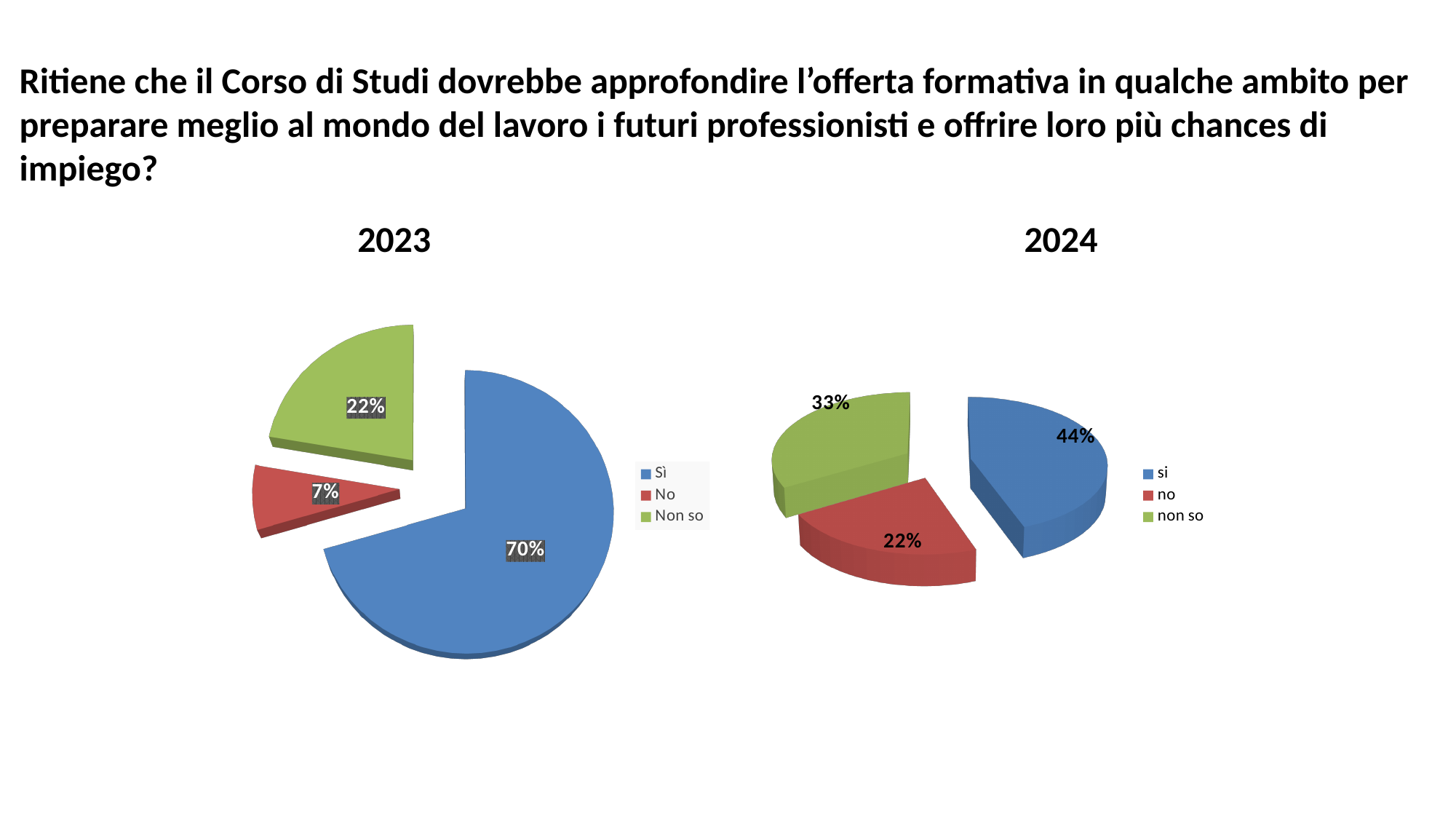
Which is larger: the "Non so" share in the 2023 chart or the "non so" share in the 2024 chart? 2024 What is the difference between the "Sì" share in the 2023 chart and the "si" share in the 2024 chart? 26 percentage points In the 2024 chart, which answer has the smallest slice? no How many entries does the legend of the 2023 chart list? 3 What type of chart is used for the 2024 data? Pie chart In the 2023 chart, what share of respondents answered "Sì"? 70% In the 2024 chart, what share of respondents answered "si"? 44% In the 2024 chart, what share of respondents answered "no"? 22% In the 2023 chart, which answer has the largest slice? Sì In the 2023 chart, what share of respondents answered "Non so"? 22% In the 2024 chart, what share of respondents answered "non so"? 33% In the 2023 chart, what share of respondents answered "No"? 7%